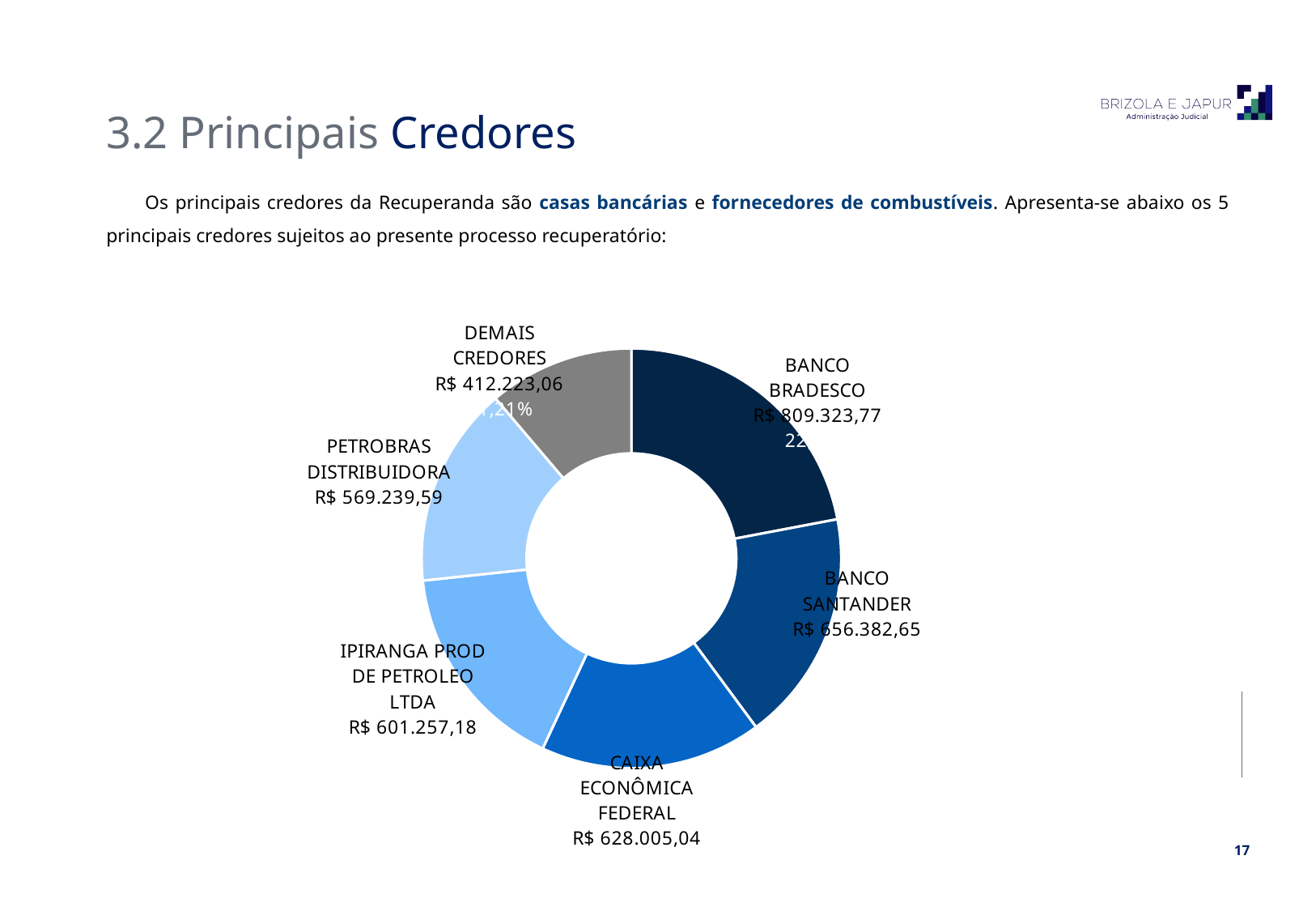
What is the value shown for DEMAIS CREDORES? R$ 412.223,06 What is the value shown for IPIRANGA PROD DE PETROLEO LTDA? R$ 601.257,18 What is the value shown for BANCO BRADESCO? R$ 809.323,77 What is the value shown for PETROBRAS DISTRIBUIDORA? R$ 569.239,59 What is the difference between the values for BANCO BRADESCO and BANCO SANTANDER? R$ 152.941,12 What is the value shown for CAIXA ECONÔMICA FEDERAL? R$ 628.005,04 What kind of chart is shown on the slide? Pie chart (donut) What is the value shown for BANCO SANTANDER? R$ 656.382,65 Which is larger, the value for CAIXA ECONÔMICA FEDERAL or the value for IPIRANGA PROD DE PETROLEO LTDA? CAIXA ECONÔMICA FEDERAL Which slice has the smallest value in the chart? DEMAIS CREDORES Which creditor has the largest value in the chart? BANCO BRADESCO How many slices does the chart have? 6